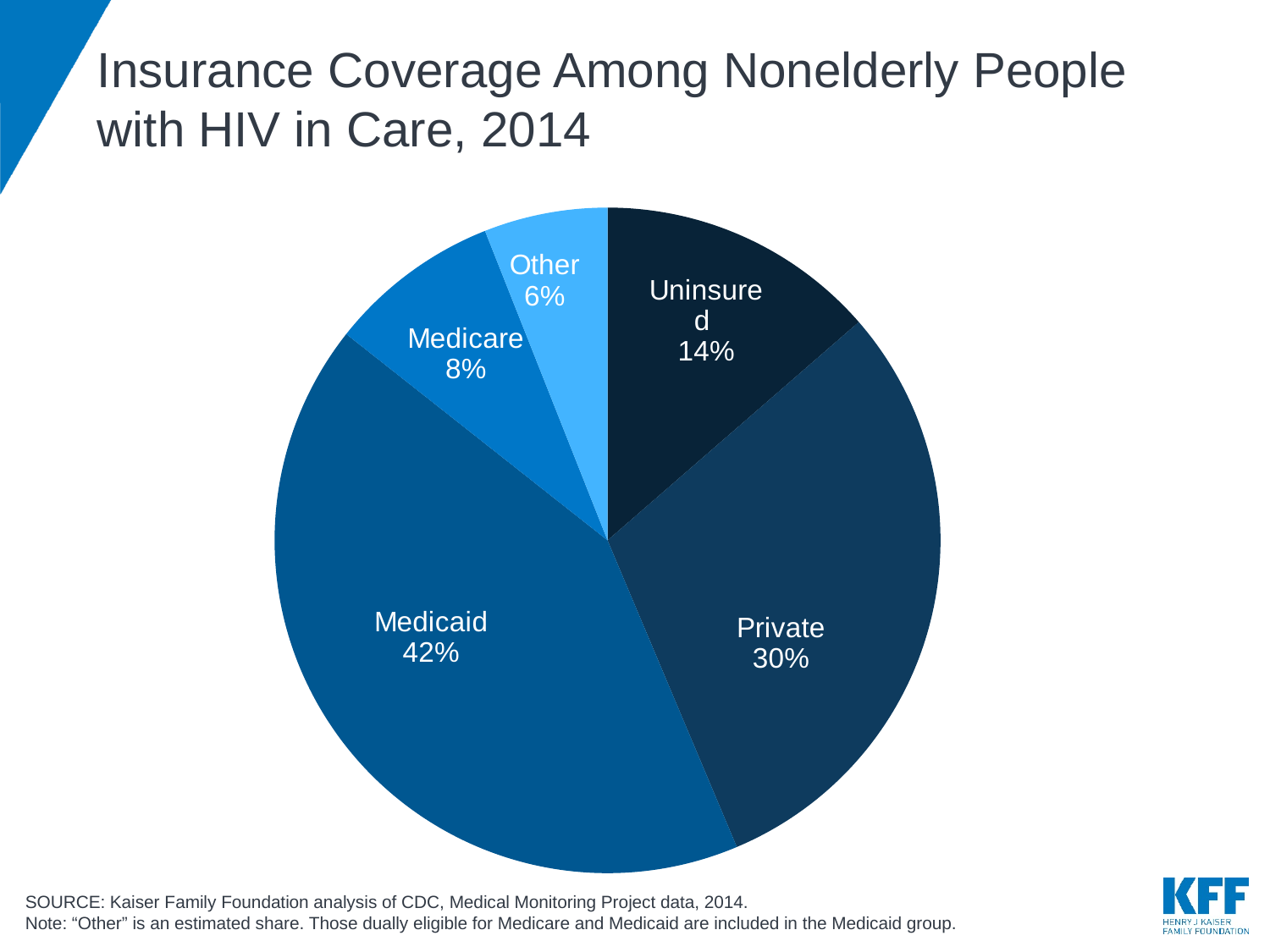
How many percentage points larger is the Medicaid share than the Private share? 12 What share of nonelderly people with HIV in care were covered by Medicaid? 42% What share of the pie is labelled Other? 6% Which coverage category has the largest share of the pie? Medicaid How many slices does the pie chart have? 5 Which coverage category has the smallest share of the pie? Other Which is larger, the Private share or the Uninsured share? Private What is the difference in percentage points between the Uninsured share and the Medicare share? 6 What percentage of nonelderly people with HIV in care were uninsured? 14% What share of nonelderly people with HIV in care had private insurance? 30% What share of the pie is labelled Medicare? 8% What type of chart is shown on the slide? Pie chart